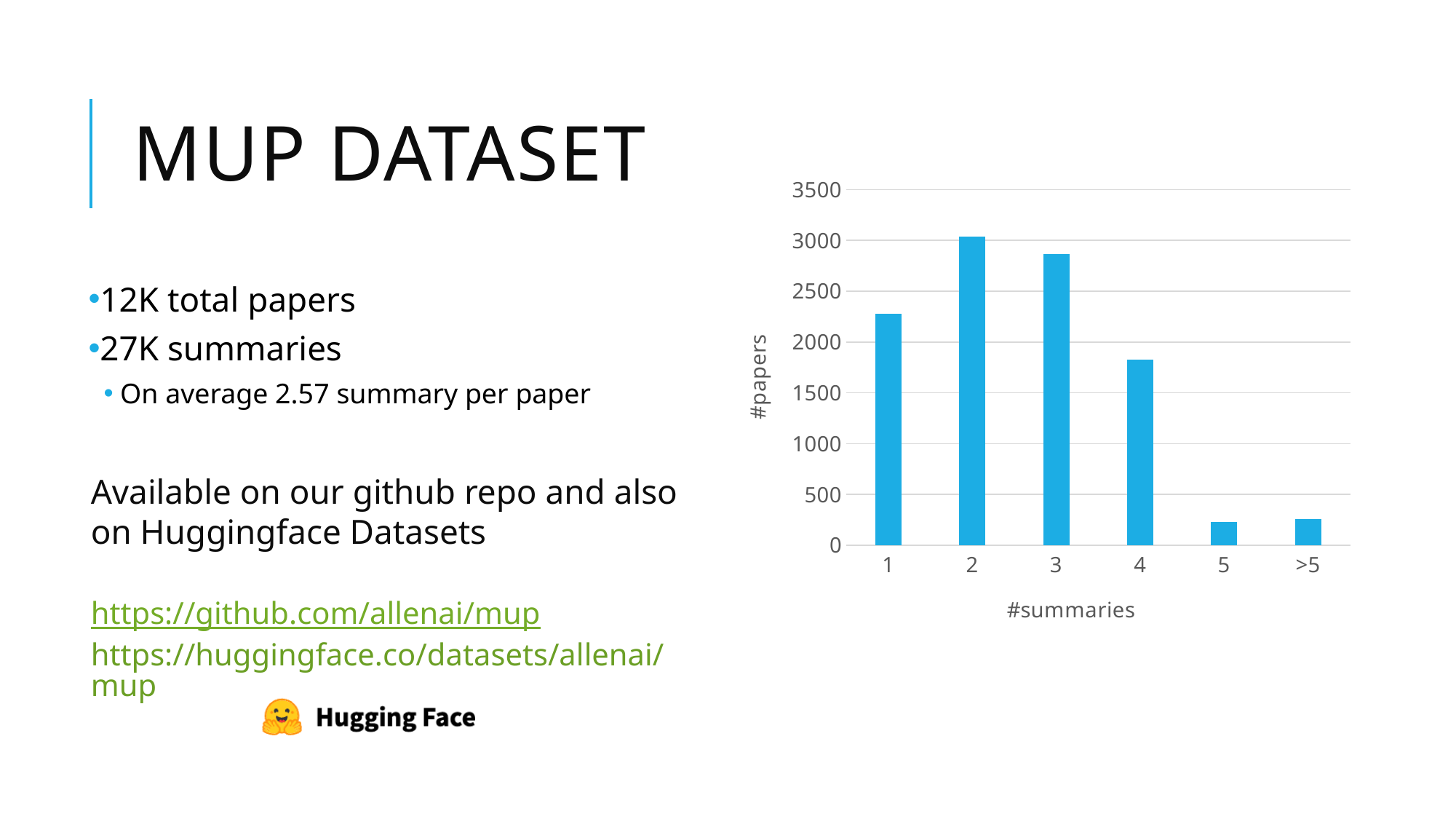
Is the value for 3 summaries greater or less than 3000? less What kind of chart is shown on the slide? bar chart Which has more papers: 1 summary or 4 summaries? 1 Which has more papers: 3 summaries or 4 summaries? 3 Which number of summaries has the highest number of papers? 2 Is the value for 1 summary greater or less than 2000? greater How many categories are shown on the x axis of the chart? 6 Is the value for 4 summaries greater or less than 2000? less What is the label of the y axis of the chart? #papers Do the values rise or fall from 2 summaries to 5 summaries? fall